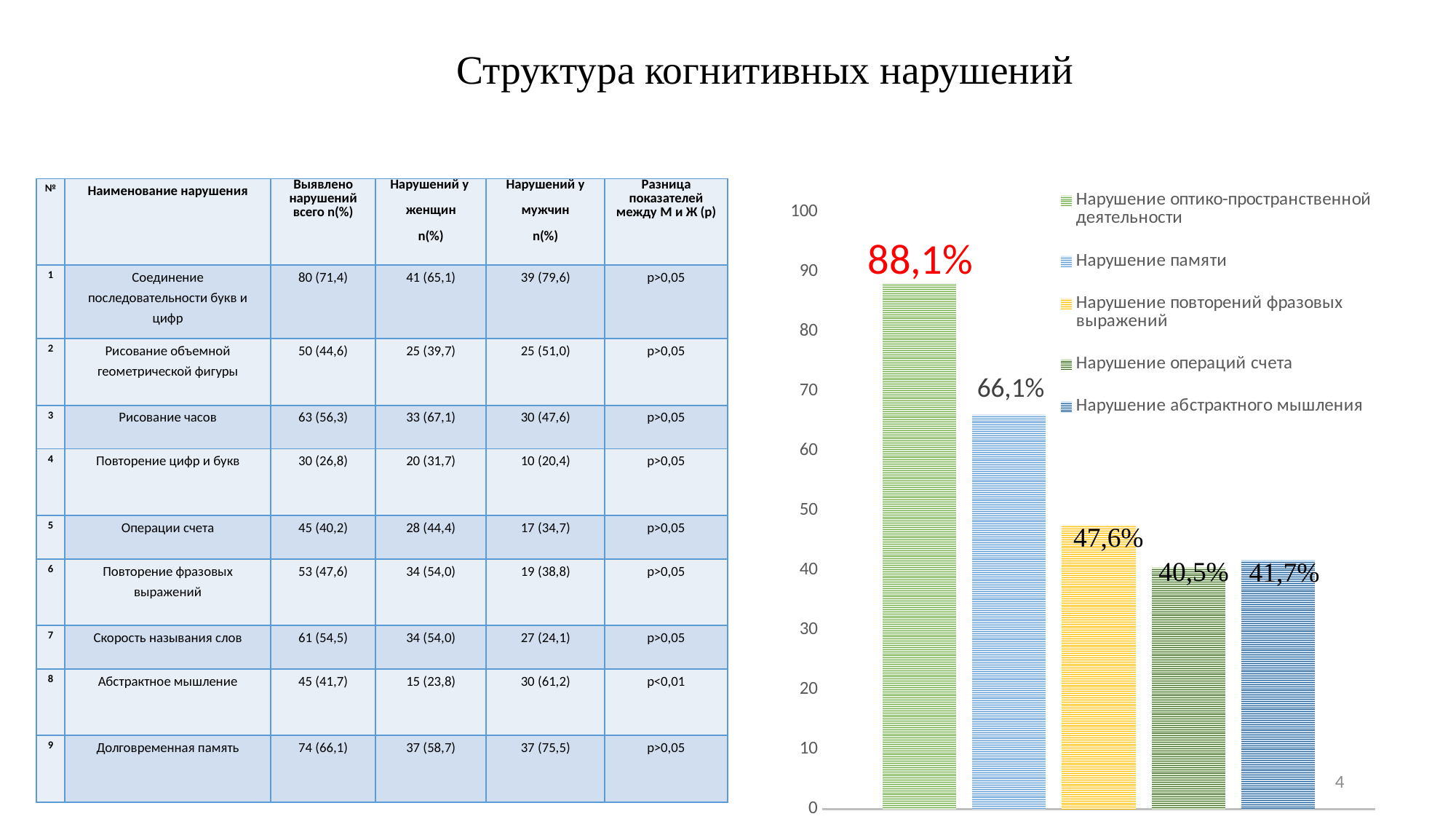
Is the value for Нарушение памяти in the bar chart greater or less than 60? greater In the bar chart, which is larger: the value for Нарушение памяти or the value for Нарушение повторений фразовых выражений? Нарушение памяти What is the value shown for Нарушение памяти in the bar chart? 66,1% Which category has the lowest value in the bar chart? Нарушение операций счета Which category has the highest value in the bar chart? Нарушение оптико-пространственной деятельности What is the difference between the values for Нарушение оптико-пространственной деятельности and Нарушение памяти in the bar chart? 22 percentage points How many entries does the legend of the bar chart list? 5 What type of chart is shown on the right side of the slide? Bar chart What is the value shown for Нарушение абстрактного мышления in the bar chart? 41,7% How many bars are plotted in the bar chart? 5 What is the value shown for Нарушение повторений фразовых выражений in the bar chart? 47,6% What is the value shown for Нарушение оптико-пространственной деятельности in the bar chart? 88,1%